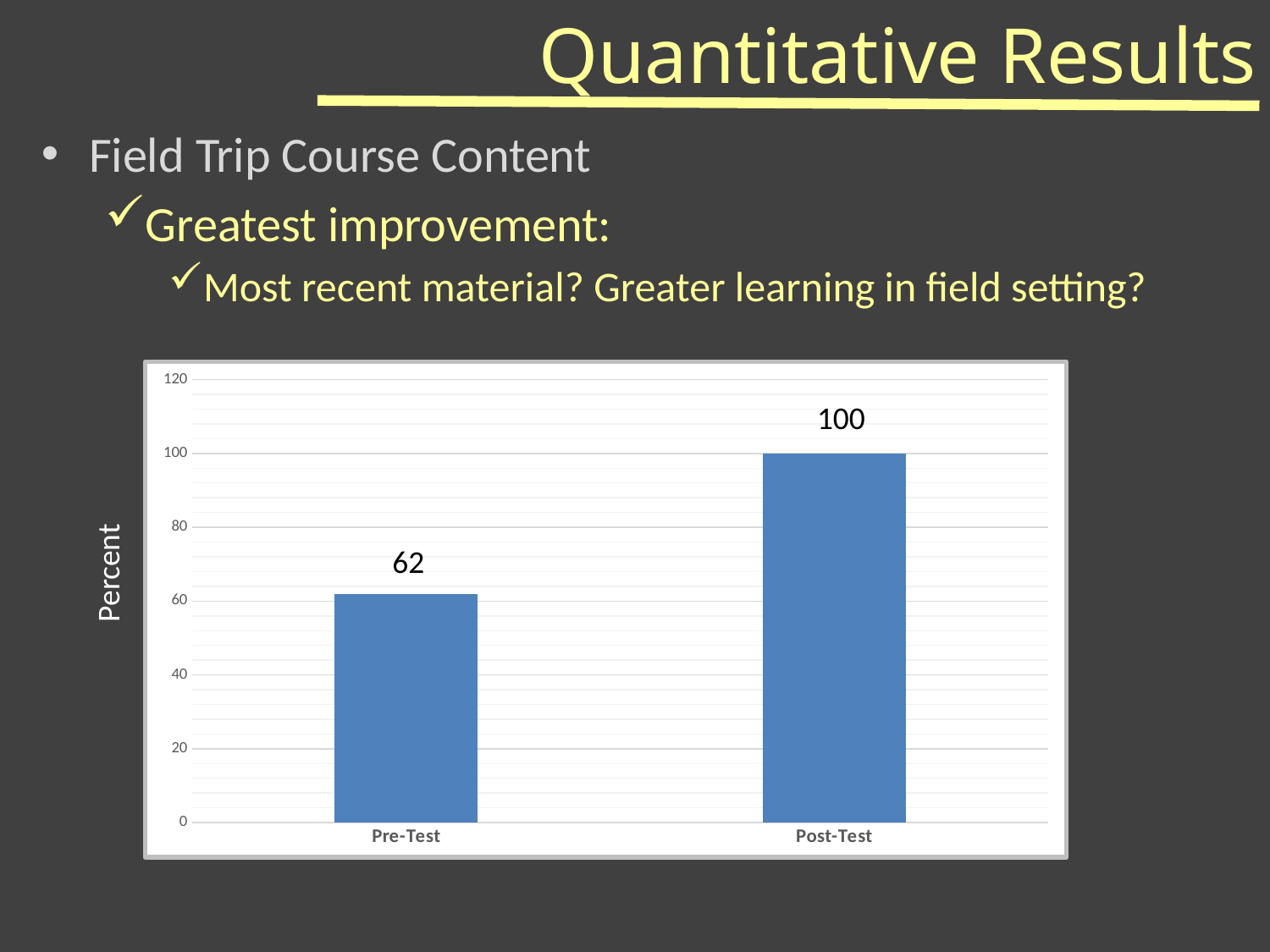
What is the label of the vertical axis? Percent What is the value for Post-Test? 100 Do the values rise or fall from Pre-Test to Post-Test? rise What is the value for Pre-Test? 62 What is the difference between the Post-Test and Pre-Test values? 38 How many categories are shown on the x axis? 2 What is the highest tick value shown on the vertical axis? 120 Which category has the highest value? Post-Test What kind of chart is shown on the slide? bar chart Is the value for Pre-Test greater or less than 80? less Which is larger, the Pre-Test value or the Post-Test value? Post-Test Which category has the lowest value? Pre-Test